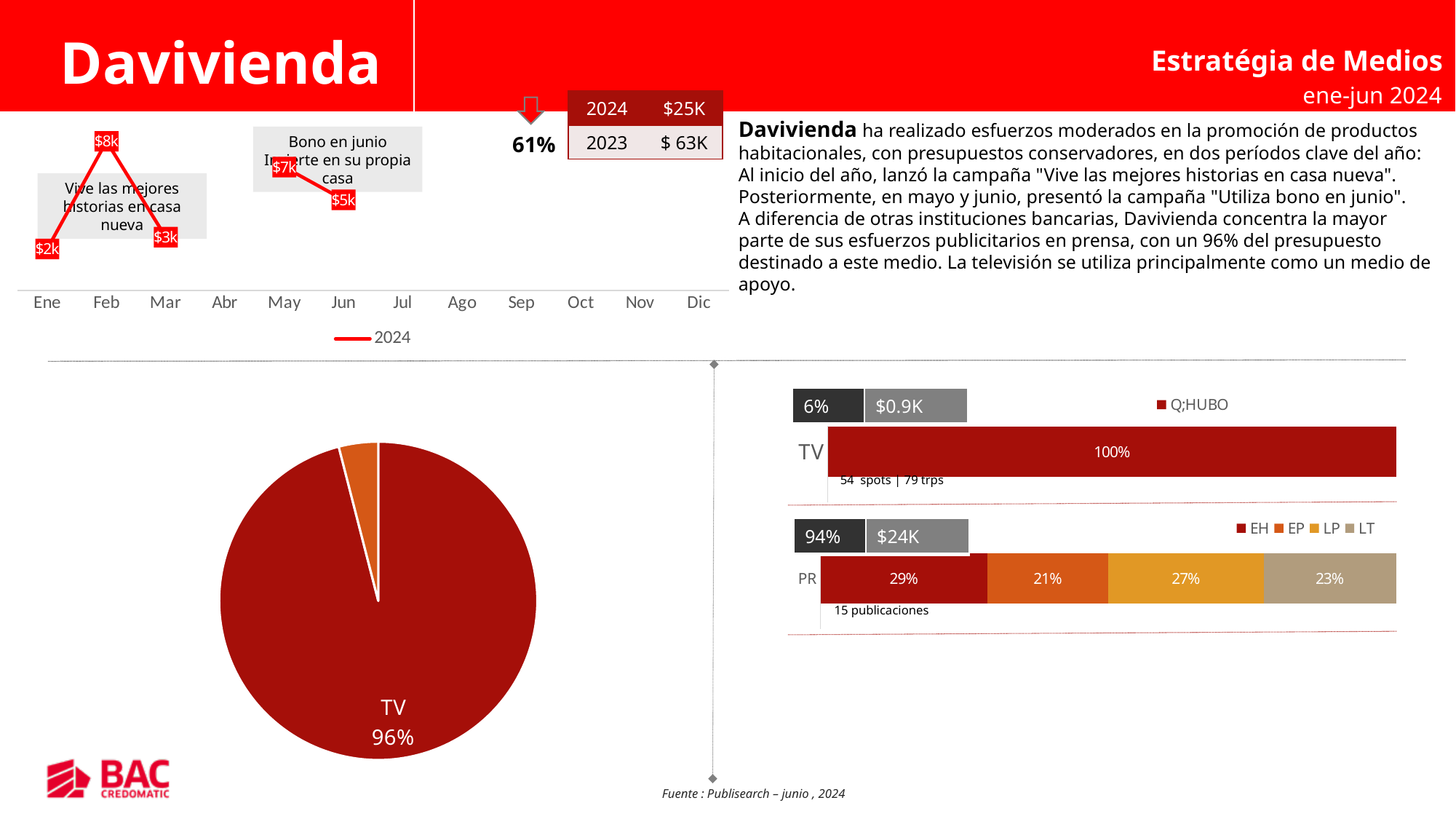
How many series does the legend of the top-left line chart list? 1 In the top-left line chart, which is larger, the value for May or the value for Jun? May What kind of chart is the top-left chart showing monthly values? Line chart In the top-left line chart, what is the difference between the Feb value and the Mar value? $5k How many series does the legend above the PR stacked bar list? 4 In the PR stacked bar on the right, which segment is the smallest? EP What percentage is printed on the large slice of the pie chart? 96% In the PR stacked bar on the right, what is the value for EH? 29% In the top-left line chart, what is the value for Feb? $8k How many months are shown on the x axis of the top-left line chart? 12 In the top-left line chart, which month has the highest value? Feb In the top-left line chart, which labeled month has the lowest value? Ene